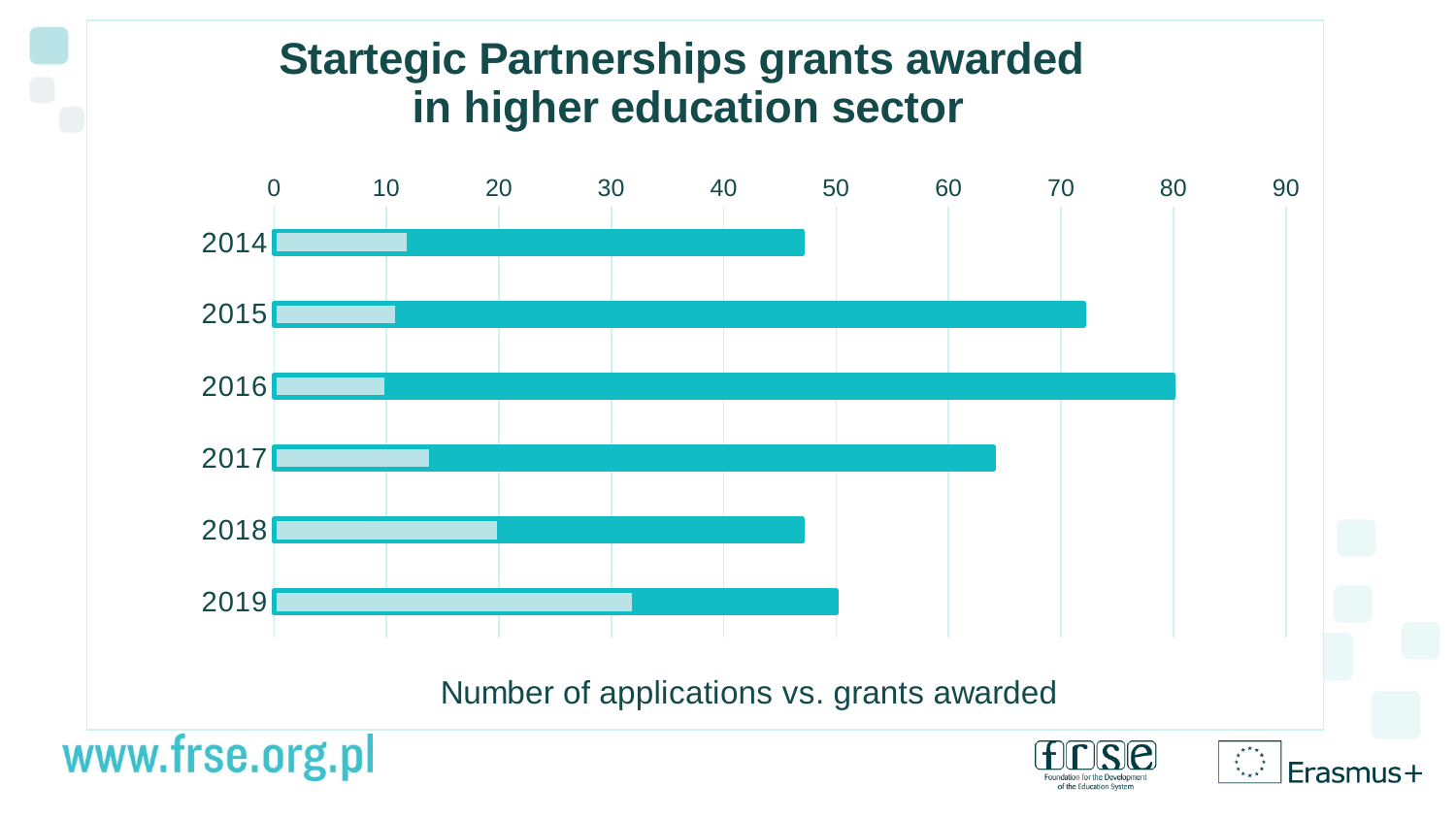
Is the number of applications in 2014 greater or less than 50? less Is the number of applications in 2016 greater or less than 70? greater What kind of chart is shown on the slide? bar chart Which year had more grants awarded, 2014 or 2019? 2019 Is the number of applications in 2015 greater or less than 60? greater What is the title of the chart? Startegic Partnerships grants awarded in higher education sector Which year has the highest number of applications (the longer bar)? 2016 Which year has the highest number of grants awarded (the shorter, lighter bar)? 2019 How many years are shown on the chart? 6 Which year had more applications, 2017 or 2018? 2017 Did the number of applications rise or fall from 2014 to 2016? rise